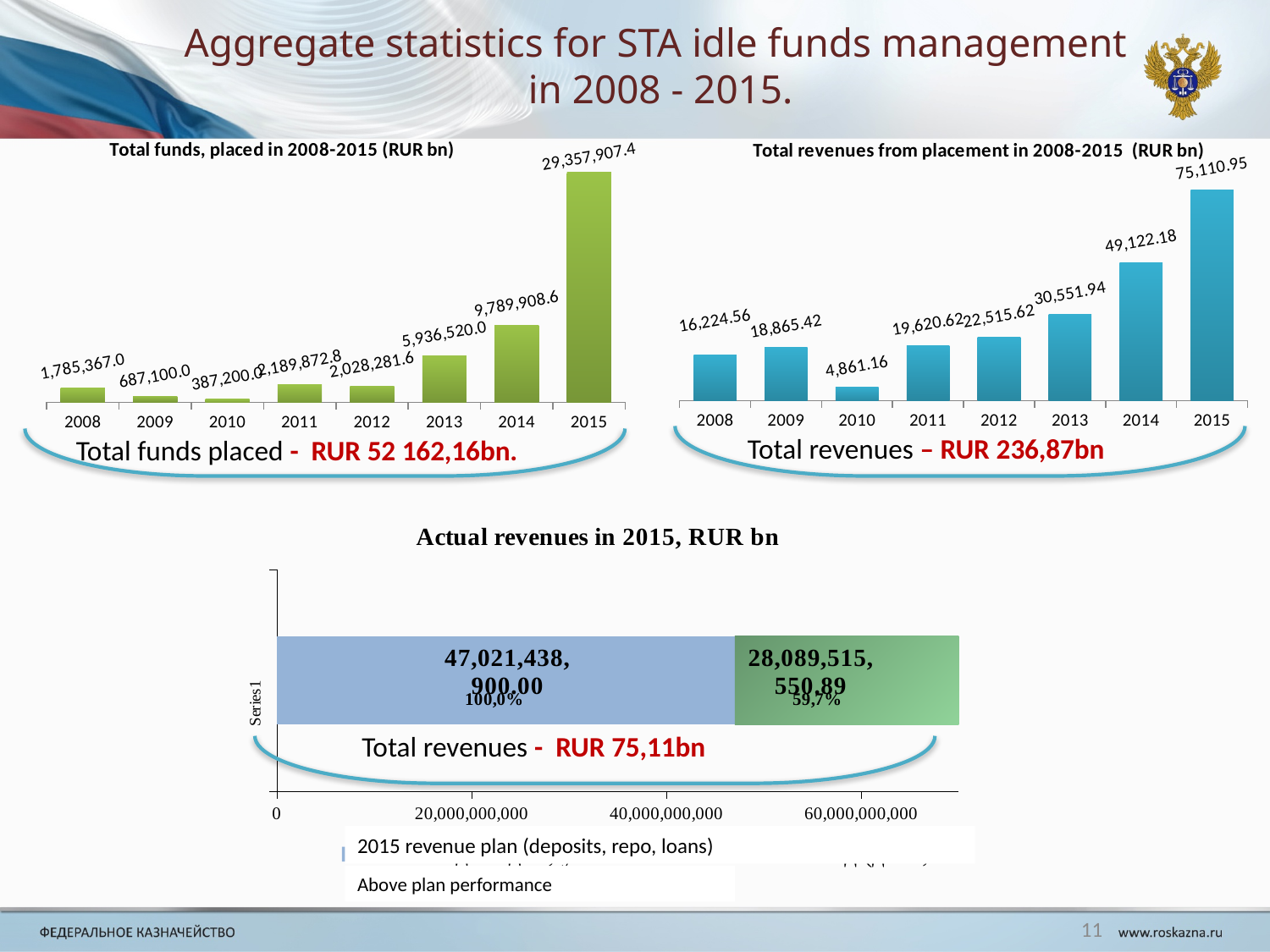
In the 'Total revenues from placement in 2008-2015 (RUR bn)' chart, do the values generally rise or fall from 2011 to 2015? rise In the 'Total revenues from placement in 2008-2015 (RUR bn)' chart, what is the value for 2010? 4,861.16 In the 'Total revenues from placement in 2008-2015 (RUR bn)' chart, which is larger, the value for 2009 or the value for 2011? 2011 What kind of chart is 'Actual revenues in 2015, RUR bn'? bar chart In the 'Total revenues from placement in 2008-2015 (RUR bn)' chart, what is the difference between the 2015 and 2014 values? 25,988.77 In the 'Actual revenues in 2015, RUR bn' chart, what is the value of the '2015 revenue plan (deposits, repo, loans)' segment? 47,021,438,900.00 In the 'Total funds, placed in 2008-2015 (RUR bn)' chart, which year has the lowest value? 2010 In the 'Total funds, placed in 2008-2015 (RUR bn)' chart, what is the value for 2015? 29,357,907.4 In the 'Total funds, placed in 2008-2015 (RUR bn)' chart, what is the value for 2013? 5,936,520.0 In the 'Total revenues from placement in 2008-2015 (RUR bn)' chart, which year has the highest value? 2015 In the 'Actual revenues in 2015, RUR bn' chart, what is the total of the stacked bar? 75,110,954,450.89 In the 'Total funds, placed in 2008-2015 (RUR bn)' chart, how many years are shown on the x axis? 8